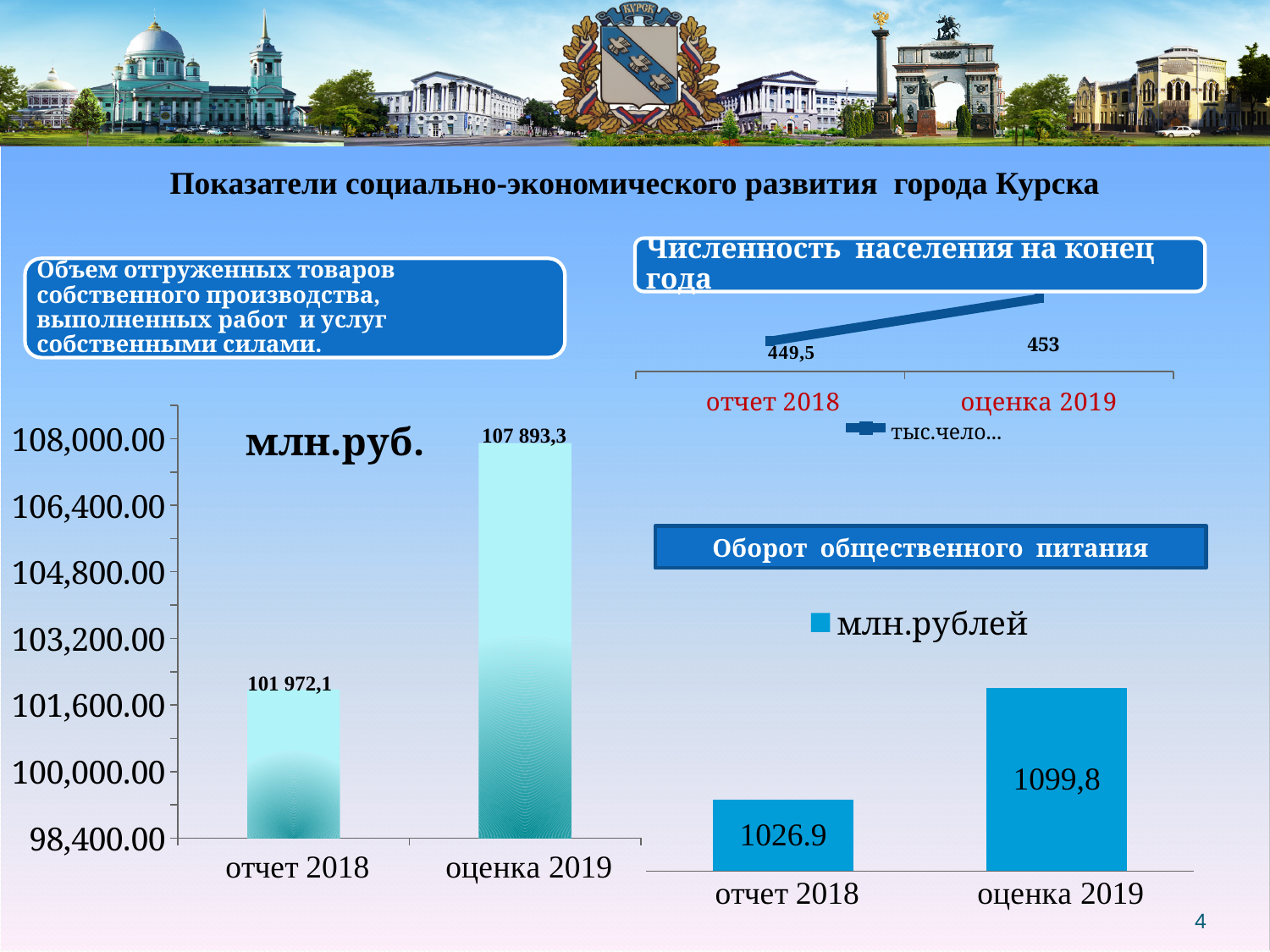
In the chart 'Объем отгруженных товаров собственного производства, выполненных работ и услуг собственными силами', what is the value for отчет 2018? 101 972,1 In the chart 'Численность населения на конец года', what is the value for оценка 2019? 453 In the chart 'Численность населения на конец года', do the values rise or fall from отчет 2018 to оценка 2019? rise In the chart 'Оборот общественного питания', which category has the higher value? оценка 2019 What kind of chart is 'Численность населения на конец года'? line chart In the chart 'Объем отгруженных товаров собственного производства, выполненных работ и услуг собственными силами', what is the difference between оценка 2019 and отчет 2018? 5 921,2 In the chart 'Объем отгруженных товаров собственного производства, выполненных работ и услуг собственными силами', what is the value for оценка 2019? 107 893,3 In the chart 'Оборот общественного питания', what is the value for отчет 2018? 1026.9 In the chart 'Оборот общественного питания', what is the value for оценка 2019? 1099,8 In the chart 'Численность населения на конец года', what is the value for отчет 2018? 449,5 In the chart 'Оборот общественного питания', what series name does the legend show? млн.рублей In the chart 'Объем отгруженных товаров собственного производства, выполненных работ и услуг собственными силами', what unit is shown on the chart? млн.руб.